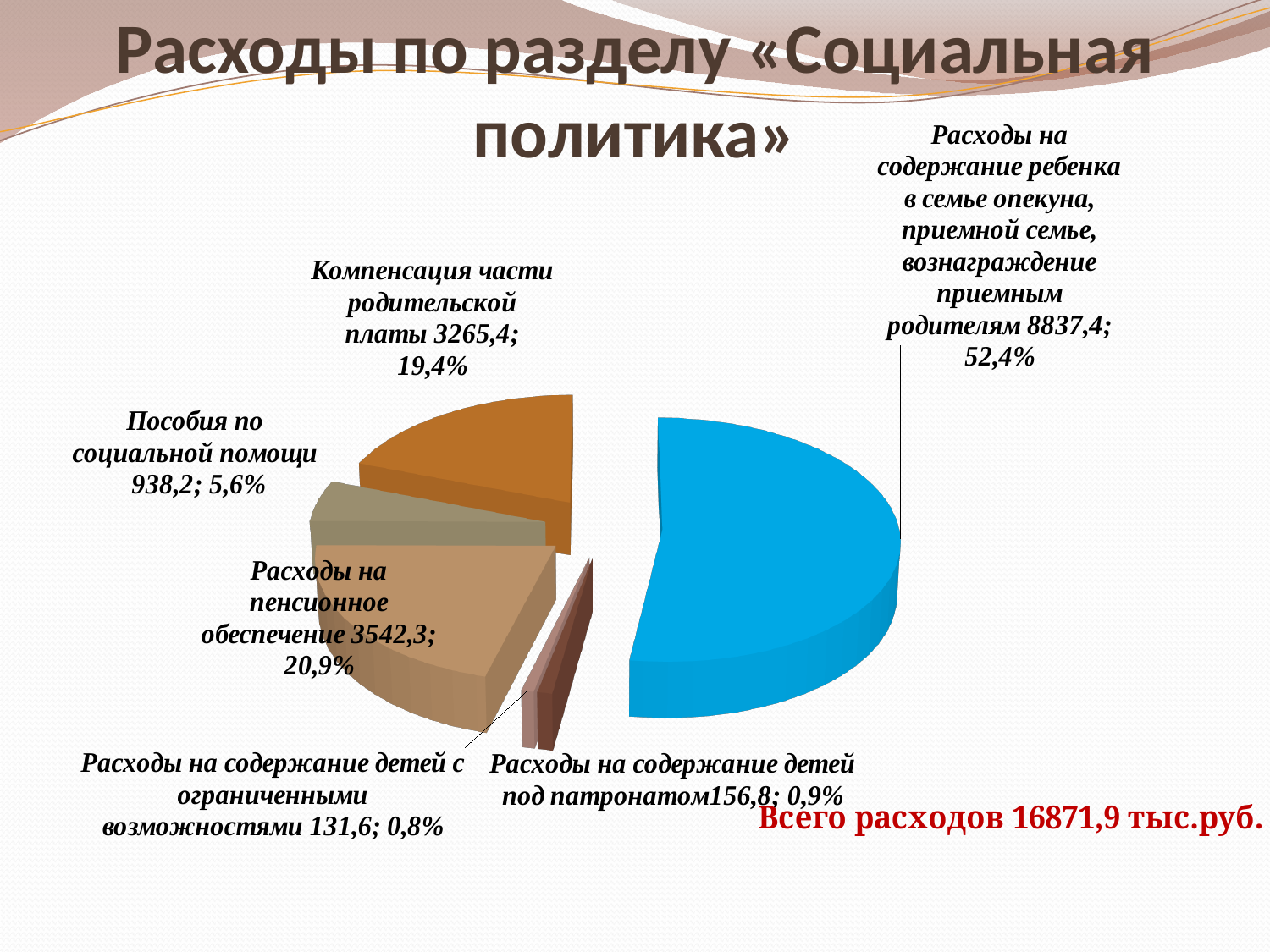
What kind of chart is shown on the slide? Pie chart What share of the pie does «Расходы на содержание детей под патронатом» represent? 0,9% Which category has the largest slice of the pie? Расходы на содержание ребенка в семье опекуна, приемной семье, вознаграждение приемным родителям What is the value shown for «Компенсация части родительской платы»? 3265,4 What share of the pie does «Расходы на содержание ребенка в семье опекуна, приемной семье, вознаграждение приемным родителям» represent? 52,4% What is the difference between the values for «Расходы на пенсионное обеспечение» and «Компенсация части родительской платы»? 276,9 What is the value shown for «Пособия по социальной помощи»? 938,2 What is the value shown for «Расходы на пенсионное обеспечение»? 3542,3 How many slices does the pie chart have? 6 What total expenditure is stated on the slide? 16871,9 тыс.руб. Which category has the smallest slice of the pie? Расходы на содержание детей с ограниченными возможностями Which is larger: «Расходы на содержание детей под патронатом» or «Расходы на содержание детей с ограниченными возможностями»? Расходы на содержание детей под патронатом